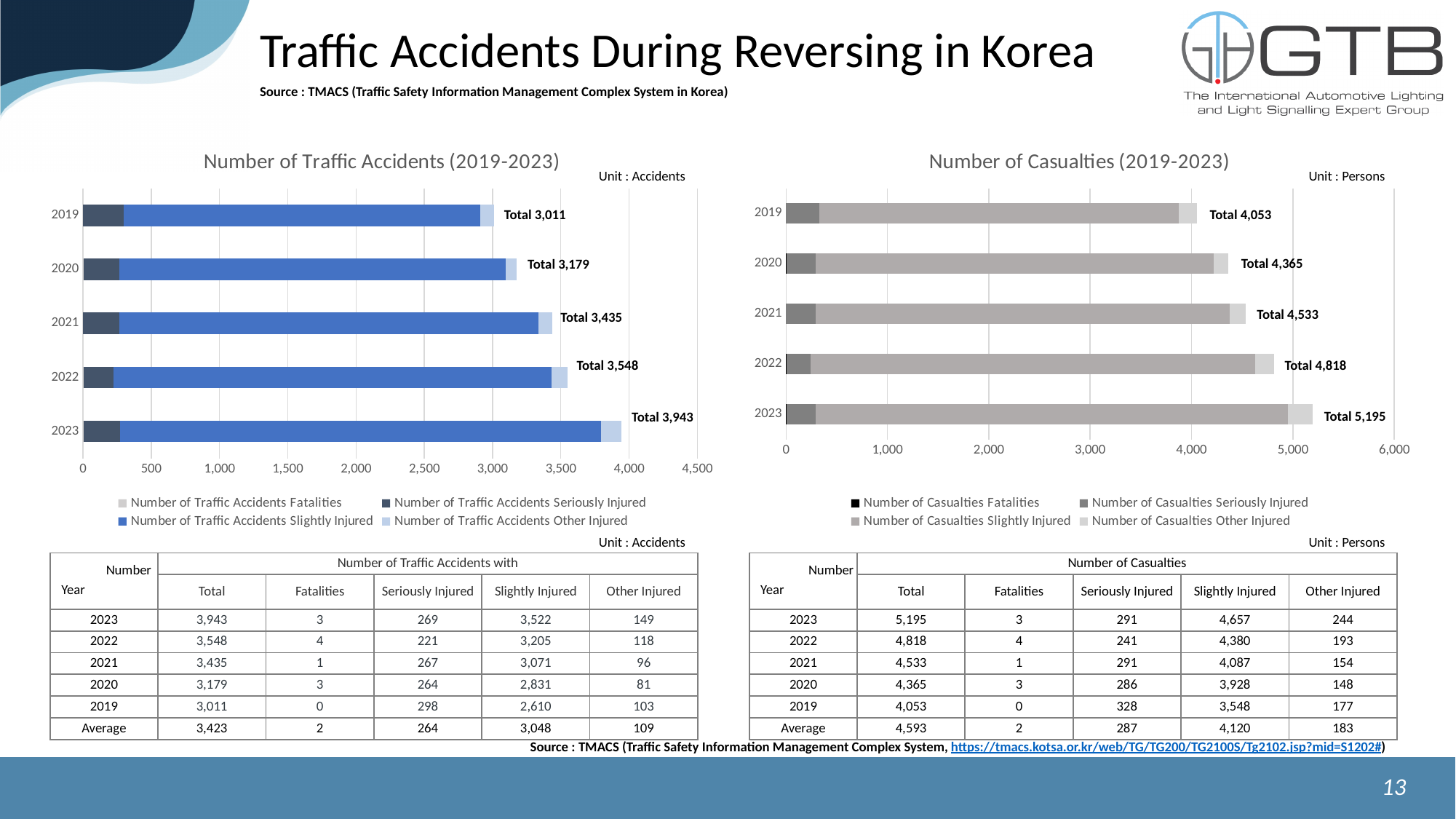
How many series does the legend of the Number of Casualties (2019-2023) chart list? 4 In the Number of Casualties (2019-2023) chart, is the total for 2023 greater or less than 5,000? greater In the Number of Traffic Accidents (2019-2023) chart, which year has the lowest total? 2019 In the Number of Traffic Accidents (2019-2023) chart, what is the difference between the 2023 total and the 2019 total? 932 In the Number of Casualties (2019-2023) chart, what is the difference between the 2022 total and the 2021 total? 285 How many years are shown in the Number of Traffic Accidents (2019-2023) chart? 5 In the Number of Casualties (2019-2023) chart, which year has the highest total? 2023 In the Number of Traffic Accidents (2019-2023) chart, what is the total for 2023? 3,943 In the Number of Casualties (2019-2023) chart, what is the total for 2019? 4,053 In the Number of Casualties (2019-2023) chart, do the totals rise or fall from 2019 to 2023? Rise What type of chart is the Number of Traffic Accidents (2019-2023) chart? Stacked bar chart In the Number of Traffic Accidents (2019-2023) chart, is the total for 2021 larger than the total for 2020? Yes